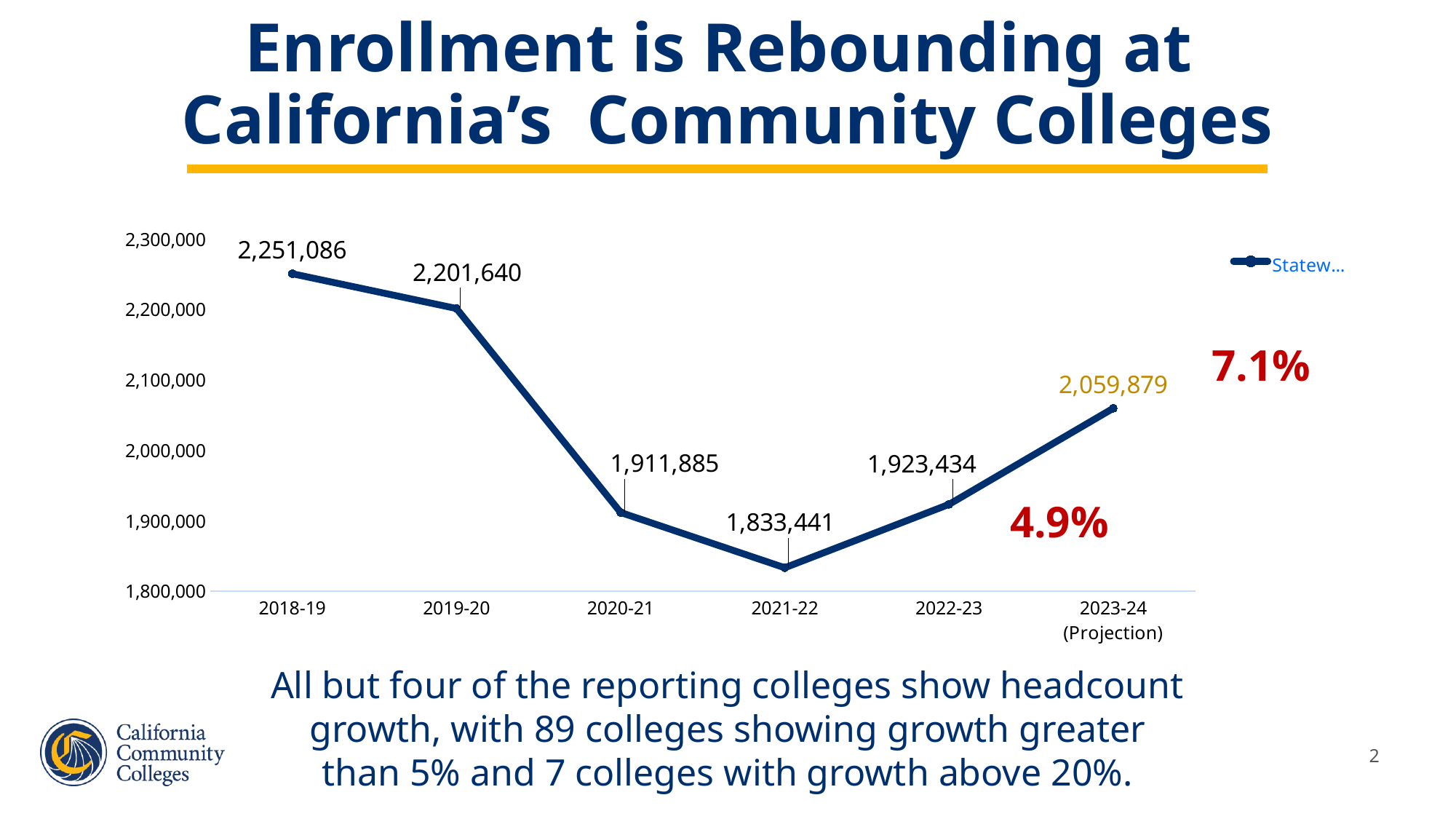
How many data points are plotted on the line? 6 Which year has the lowest enrollment value? 2021-22 Does the enrollment value rise or fall from 2021-22 to 2023-24 (Projection)? Rise Which year has the highest enrollment value? 2018-19 What is the projected enrollment value for 2023-24? 2,059,879 What type of chart is shown on the slide? Line chart What is the difference between the 2018-19 value and the 2019-20 value? 49,446 What is the enrollment value for 2018-19? 2,251,086 Which is larger, the value for 2020-21 or the value for 2022-23? 2022-23 What is the enrollment value for 2021-22? 1,833,441 What is the difference between the 2022-23 value and the 2021-22 value? 89,993 What is the enrollment value for 2022-23? 1,923,434